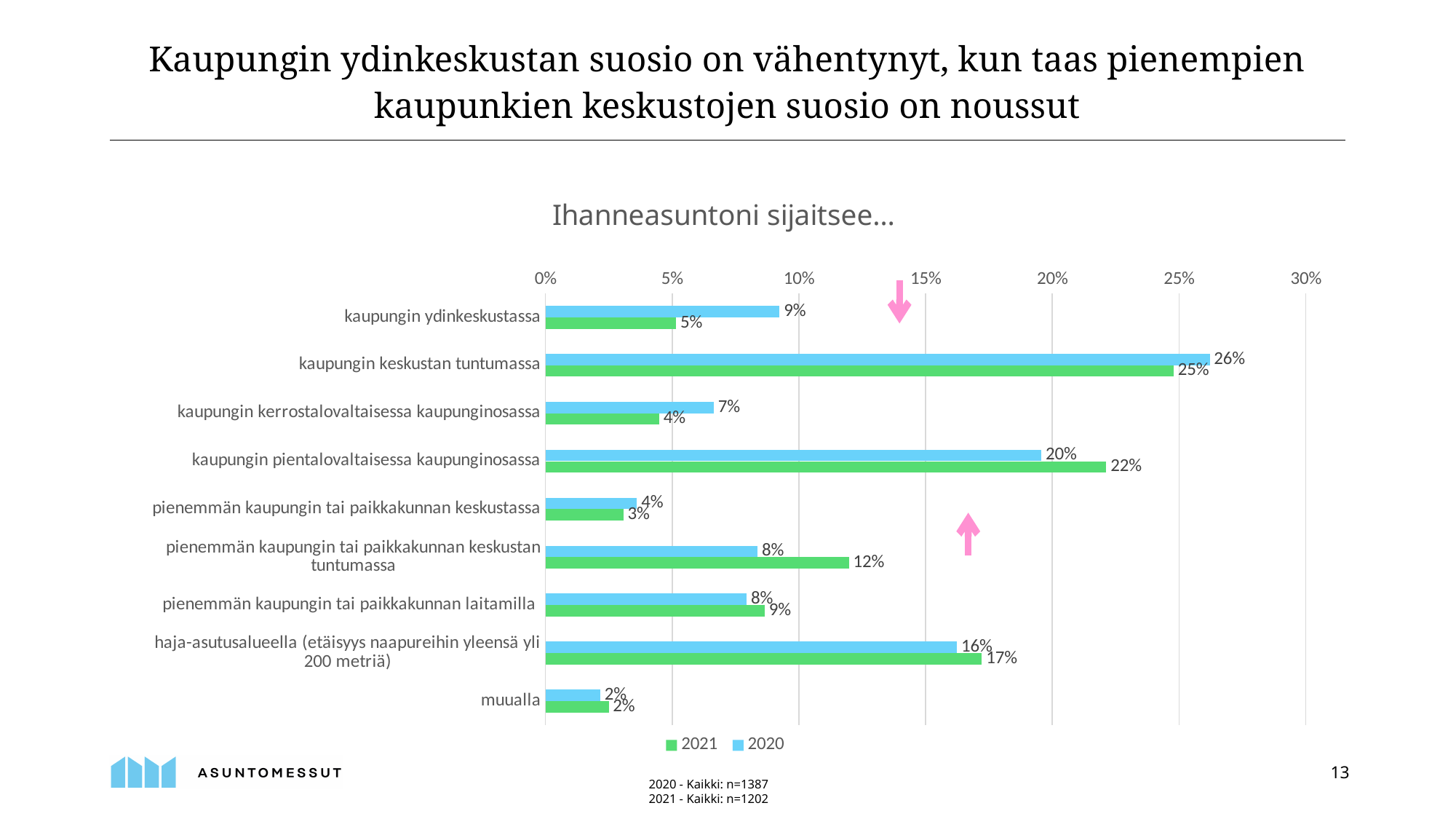
Which category has the highest 2021 value? kaupungin keskustan tuntumassa What is the 2021 value for "pienemmän kaupungin tai paikkakunnan keskustan tuntumassa"? 12% What is the title of the chart? Ihanneasuntoni sijaitsee… Is the 2021 value for "haja-asutusalueella (etäisyys naapureihin yleensä yli 200 metriä)" greater or less than 15%? greater What kind of chart is shown on the slide? bar chart What is the difference between the 2020 and 2021 values for "kaupungin ydinkeskustassa"? 4% How many categories are shown on the chart? 9 Which category has the lowest 2020 value? muualla For "kaupungin pientalovaltaisessa kaupunginosassa", which year has the larger value, 2020 or 2021? 2021 How many series does the legend list? 2 What is the 2021 value for "kaupungin ydinkeskustassa"? 5% What is the 2020 value for "kaupungin keskustan tuntumassa"? 26%